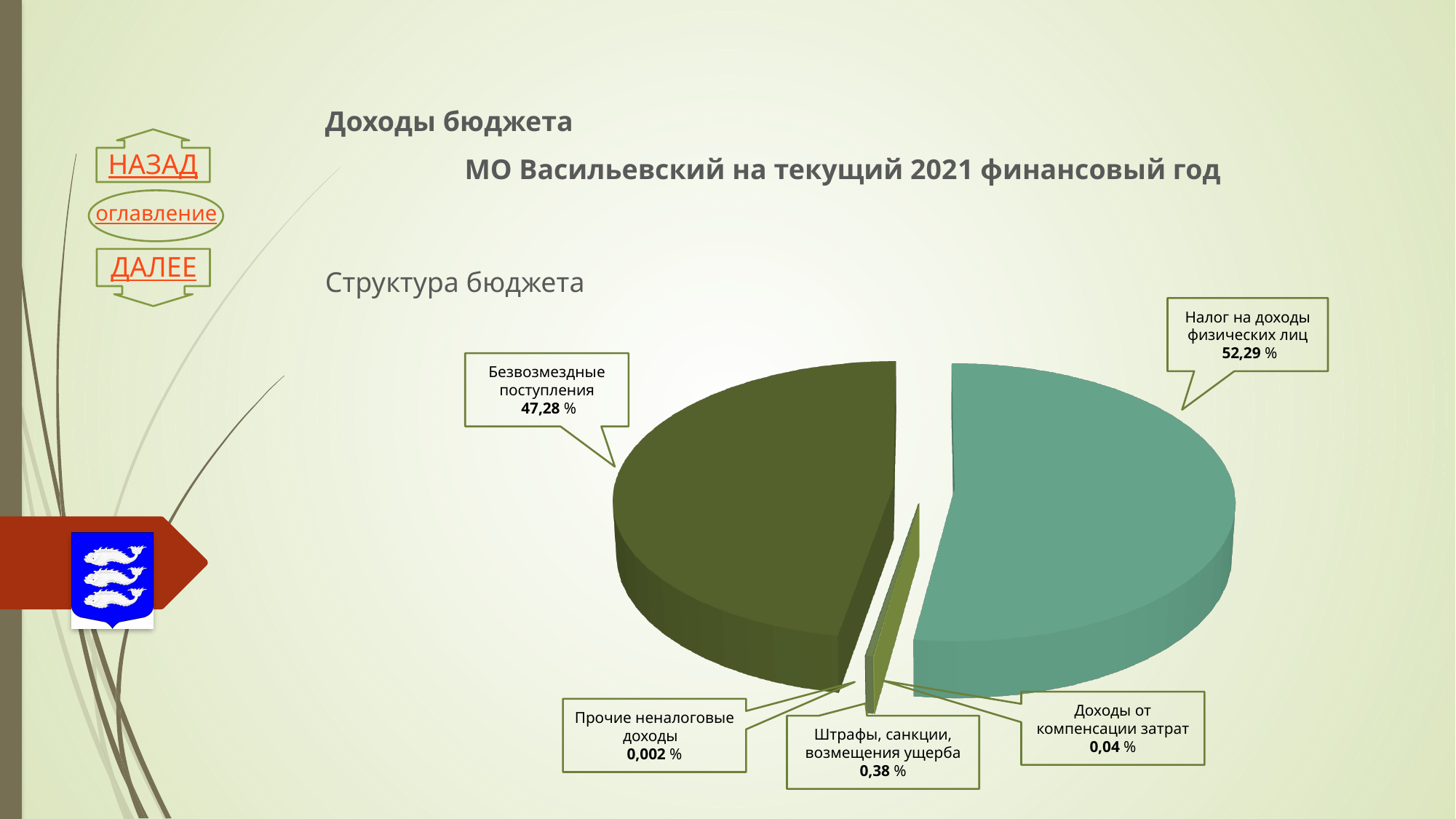
Which category has the largest share of the pie? Налог на доходы физических лиц What share of the budget is Налог на доходы физических лиц? 52,29 % What share of the budget is Доходы от компенсации затрат? 0,04 % What kind of chart is shown on the slide? pie chart Which category has the smallest share of the pie? Прочие неналоговые доходы What share of the budget is Безвозмездные поступления? 47,28 % What is the difference between the shares of Налог на доходы физических лиц and Безвозмездные поступления? 5,01 % What share of the budget is Прочие неналоговые доходы? 0,002 % How many categories are shown in the pie chart? 5 What is the subtitle shown above the pie chart? Структура бюджета What share of the budget is Штрафы, санкции, возмещения ущерба? 0,38 % Which is larger: Штрафы, санкции, возмещения ущерба or Доходы от компенсации затрат? Штрафы, санкции, возмещения ущерба